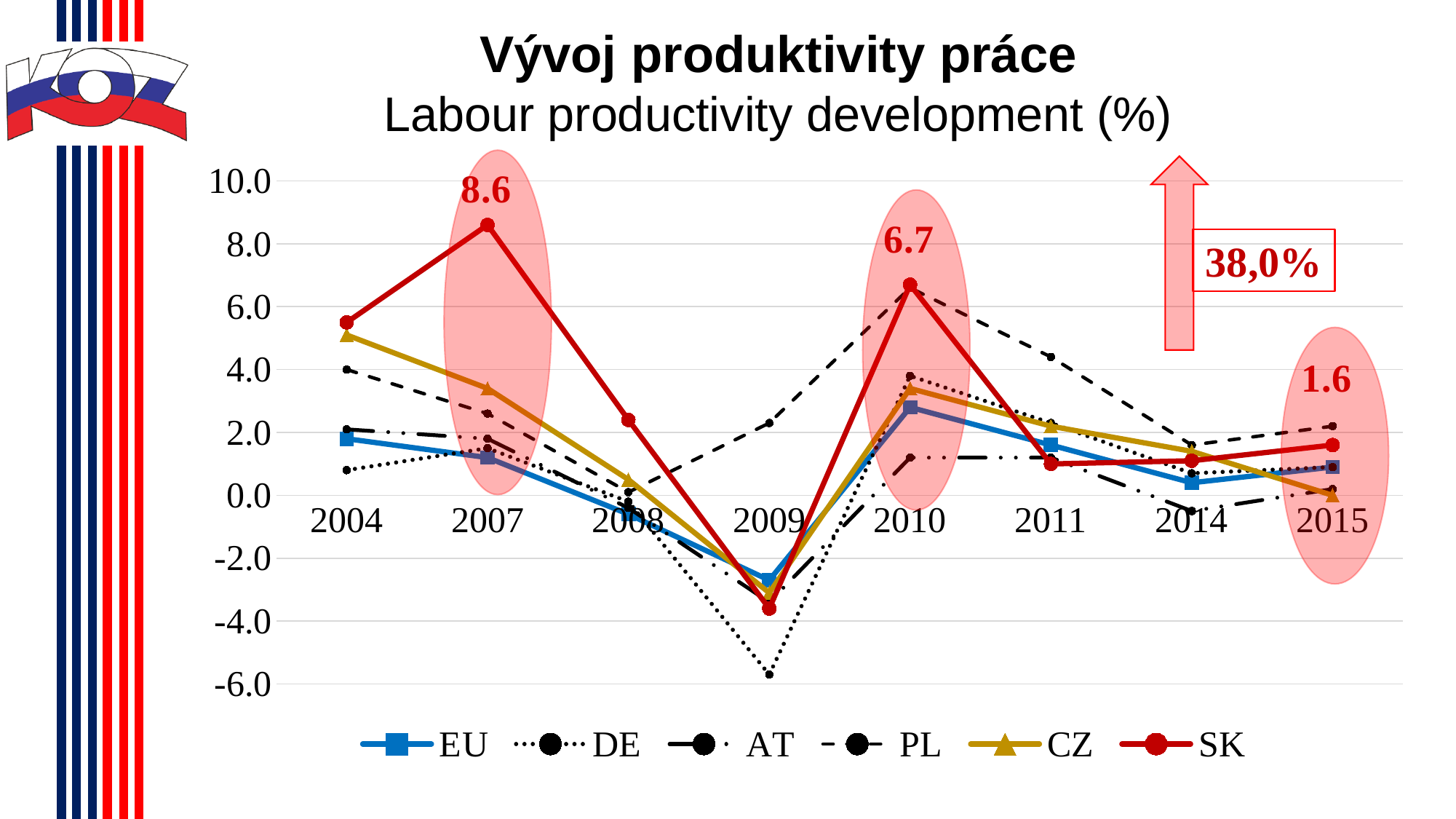
What is the difference between the SK values in 2007 and 2010? 1.9 What is the labelled value for SK in 2015? 1.6 What percentage is shown in the box next to the arrow on the right of the chart? 38,0% What kind of chart is shown on the slide? line chart Which series has the lowest value in 2009? DE Is the value for SK in 2004 greater or less than 4.0? greater What is the labelled value for SK in 2010? 6.7 In which year does the SK series reach its highest value? 2007 What is the labelled value for SK in 2007? 8.6 How many series does the legend list? 6 Does the SK series rise or fall from 2007 to 2009? fall How many years are shown on the x axis? 8